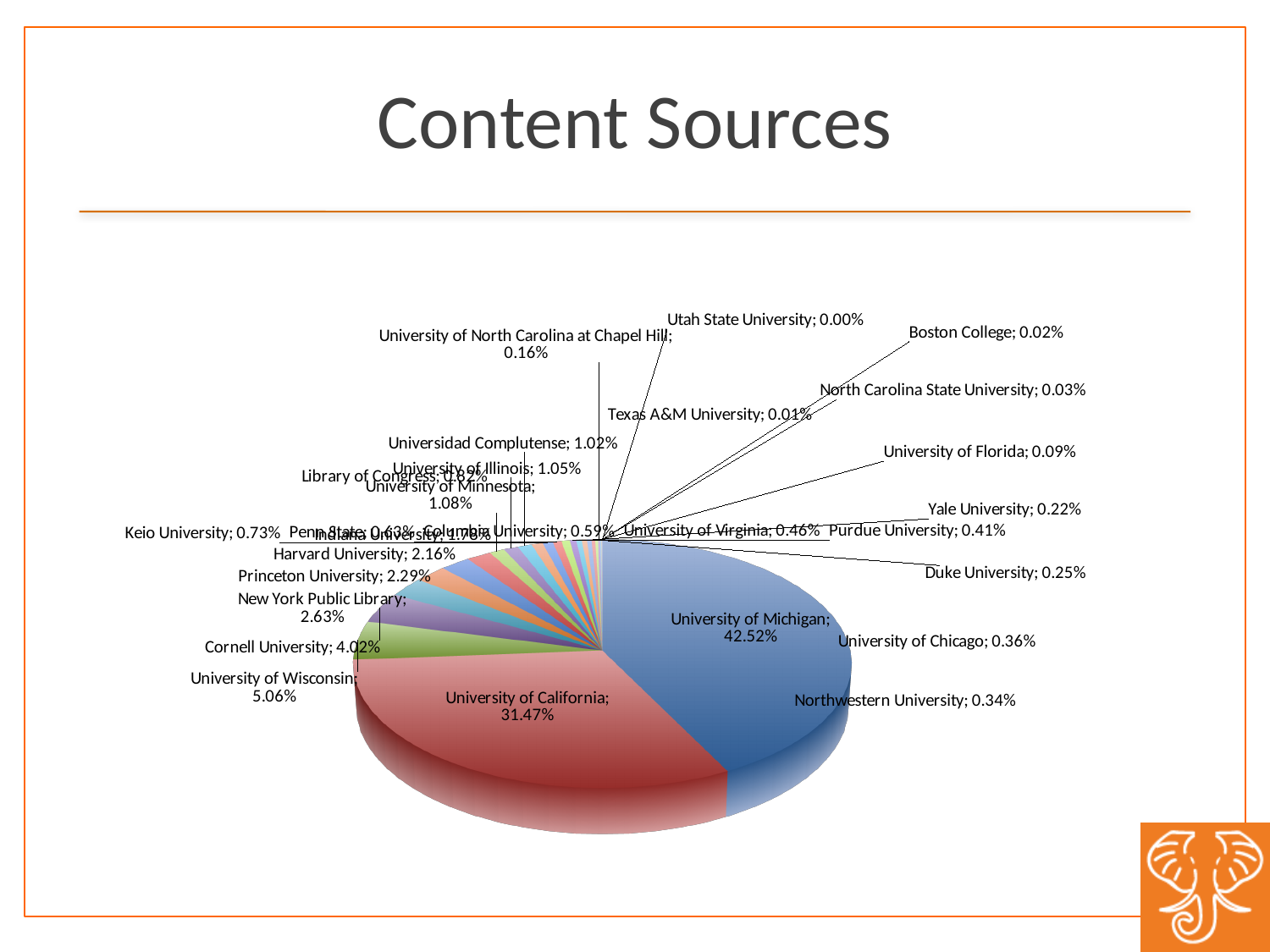
What is the value shown for Boston College? 0.02% What is the value shown for Cornell University? 4.02% What is the value shown for University of Wisconsin? 5.06% Which content source has the smallest share, at 0.00%? Utah State University What kind of chart is shown on the slide? pie chart Which content source has the largest slice of the pie? University of Michigan What is the difference between the shares of University of Michigan and University of California? 11.05% What is the value shown for University of California? 31.47% Which is larger, the share for University of Wisconsin or for Cornell University? University of Wisconsin What is the combined share of University of Michigan and University of California? 73.99% What share of the pie does University of Michigan hold? 42.52% What is the title of the chart on the slide? Content Sources